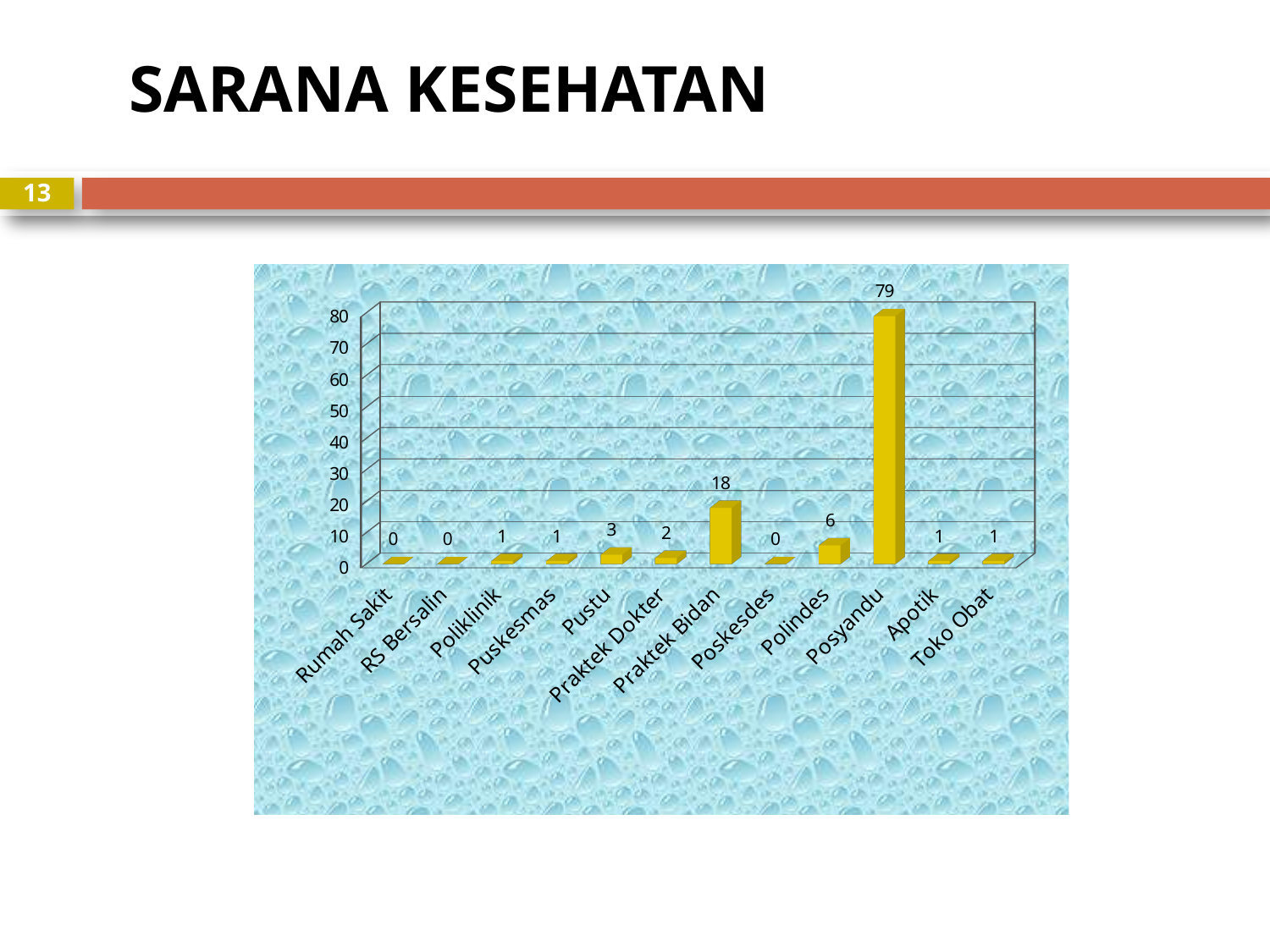
What is the value for Posyandu? 79 What is the value for Praktek Dokter? 2 What is the value for Polindes? 6 What is the value for Pustu? 3 Which category has the highest value? Posyandu Which is larger, the value for Polindes or the value for Pustu? Polindes What is the title of the slide containing the chart? SARANA KESEHATAN What kind of chart is shown on the slide? Bar chart What is the value for Praktek Bidan? 18 How many categories have a value of 0? 3 How many categories are shown on the x axis? 12 What is the difference between the values for Posyandu and Praktek Bidan? 61